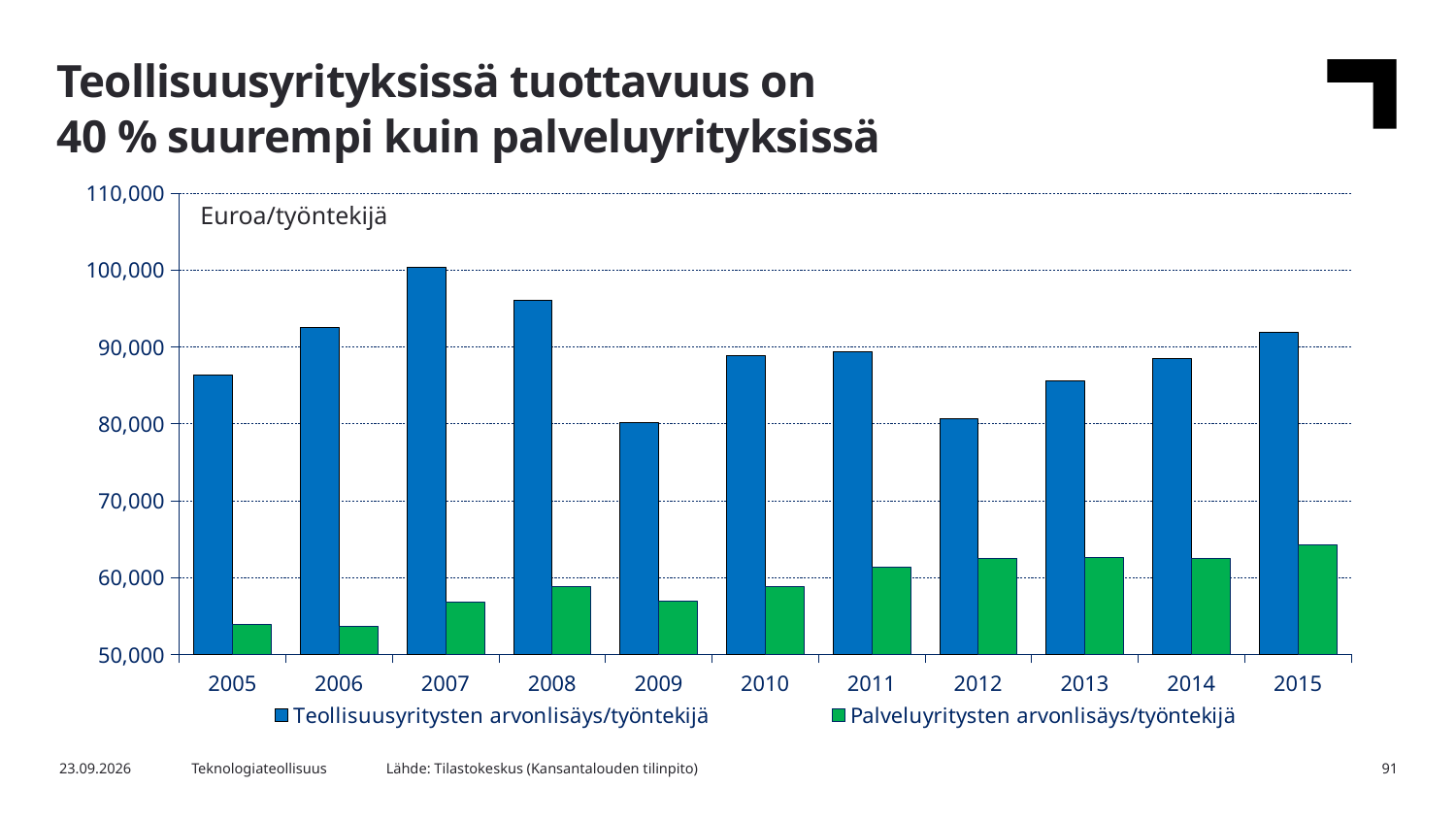
Is the value for Palveluyritysten arvonlisäys/työntekijä in 2005 greater or less than 60,000? less What kind of chart is shown on the slide? Bar chart How many series does the legend list? 2 How many years are shown on the x axis? 11 In which year is the value for Teollisuusyritysten arvonlisäys/työntekijä highest? 2007 Which is larger for Teollisuusyritysten arvonlisäys/työntekijä: the value in 2007 or in 2008? 2007 Is the value for Palveluyritysten arvonlisäys/työntekijä in 2015 greater or less than 60,000? greater Does the value for Palveluyritysten arvonlisäys/työntekijä generally rise or fall from 2005 to 2015? rise Is the value for Teollisuusyritysten arvonlisäys/työntekijä in 2009 greater or less than 90,000? less In which year is the value for Palveluyritysten arvonlisäys/työntekijä highest? 2015 What unit label is shown at the top left of the plot area? Euroa/työntekijä